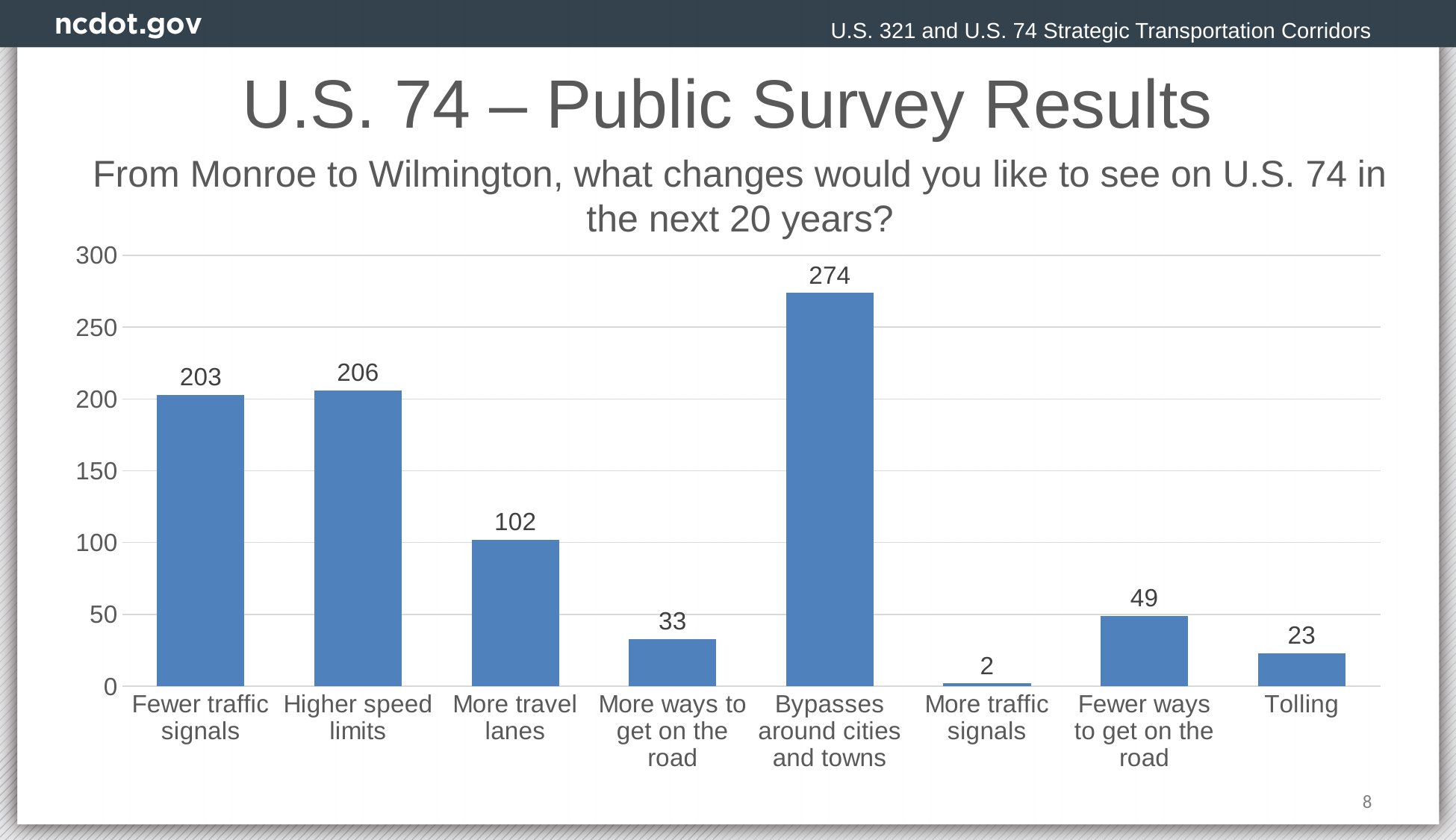
What is the difference between the values for "Higher speed limits" and "Fewer traffic signals"? 3 What question does the chart's subtitle say the survey asked? From Monroe to Wilmington, what changes would you like to see on U.S. 74 in the next 20 years? Which is larger, the value for "Fewer ways to get on the road" or the value for "More ways to get on the road"? Fewer ways to get on the road What is the difference between the values for "Bypasses around cities and towns" and "More travel lanes"? 172 What kind of chart is shown on the slide? bar chart What is the value for "More travel lanes"? 102 Which category has the highest value? Bypasses around cities and towns How many categories are shown on the x axis? 8 What is the value for "Tolling"? 23 What is the value for "Bypasses around cities and towns"? 274 Which category has the lowest value? More traffic signals Is the value for "More travel lanes" greater or less than 150? less